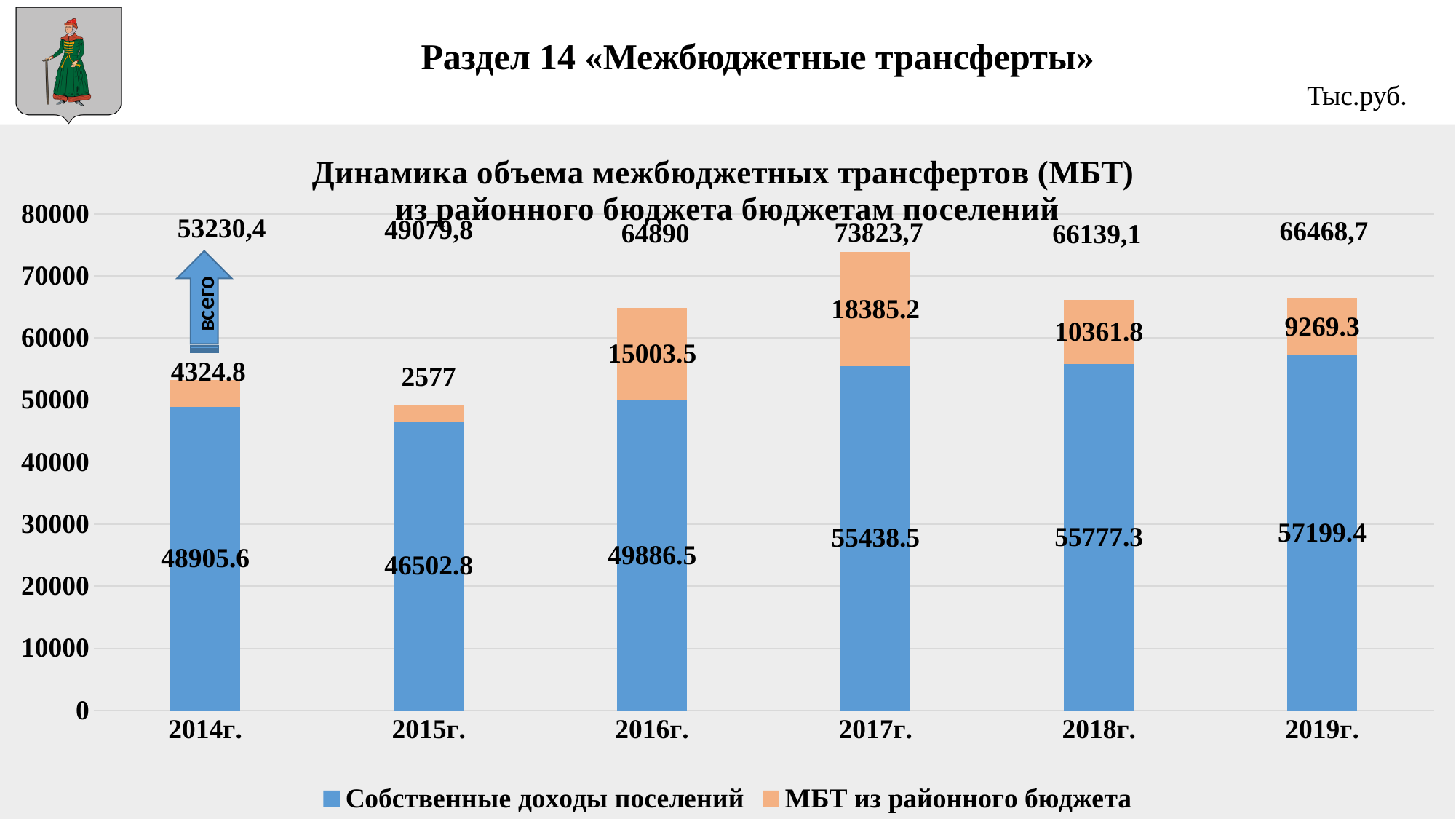
In which year is «Собственные доходы поселений» the lowest? 2015г. In which year is «МБТ из районного бюджета» the highest? 2017г. What is the total shown above the bar for 2019г.? 66468,7 What is the value of «МБТ из районного бюджета» for 2015г.? 2577 Is the total bar for 2017г. greater or less than 70000? greater What type of chart is shown on the slide? Stacked bar chart What is the value of «Собственные доходы поселений» for 2016г.? 49886.5 What is the difference between «Собственные доходы поселений» in 2019г. and in 2018г.? 1422.1 How many series does the legend list? 2 How many years are shown on the x axis? 6 What is the value of «МБТ из районного бюджета» for 2017г.? 18385.2 Which is larger: «МБТ из районного бюджета» in 2018г. or in 2019г.? 2018г.